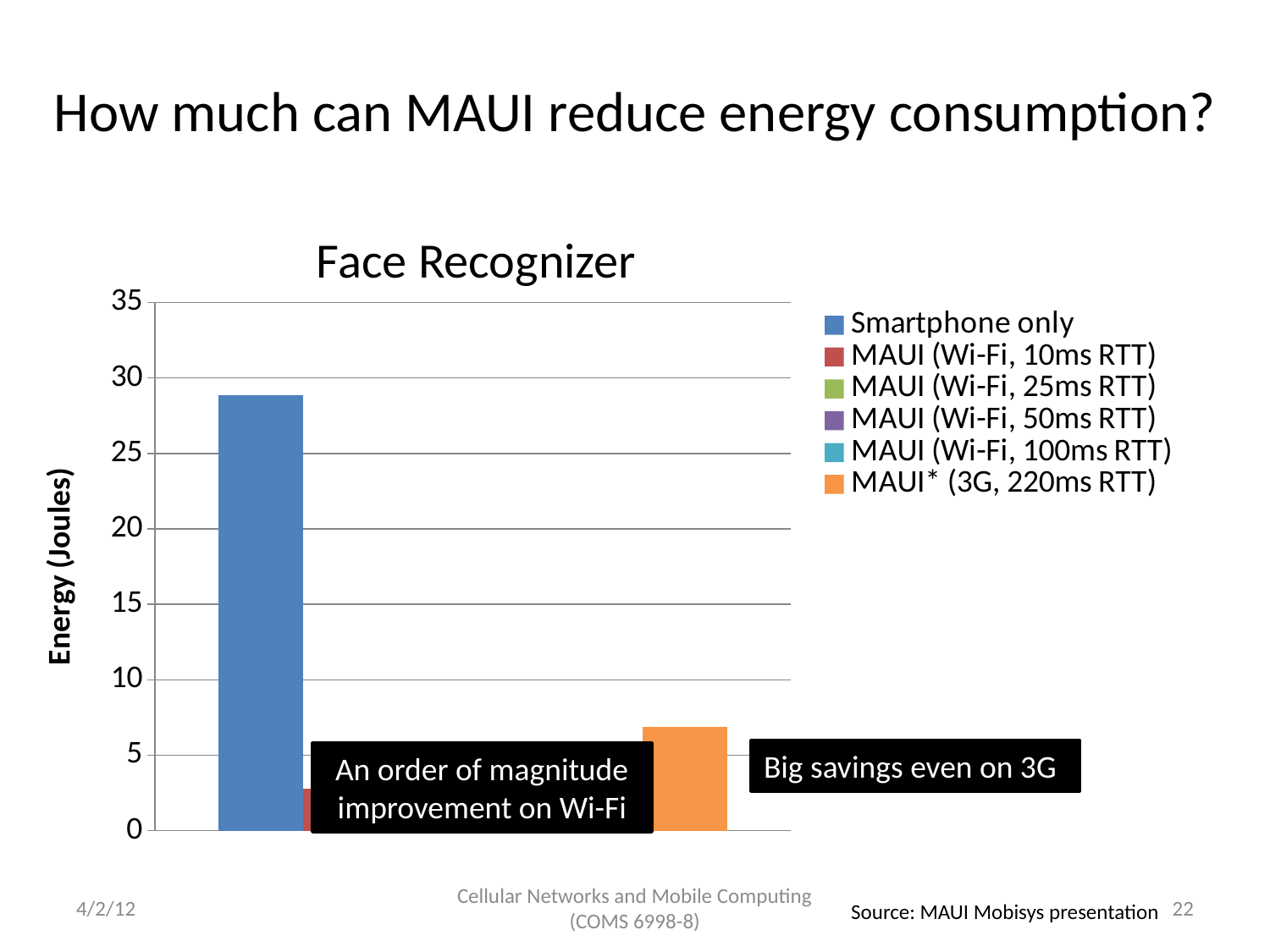
What is the title of the chart? Face Recognizer How many series does the legend list? 6 Is the value for Smartphone only greater or less than 25? greater Is the value for MAUI (Wi-Fi, 10ms RTT) greater or less than 5? less What is the label of the vertical axis? Energy (Joules) What kind of chart is shown on the slide? bar chart What is the maximum value shown on the vertical axis? 35 Is the value for MAUI* (3G, 220ms RTT) greater or less than 10? less Which is larger, the value for Smartphone only or the value for MAUI* (3G, 220ms RTT)? Smartphone only Which series has the highest energy consumption? Smartphone only